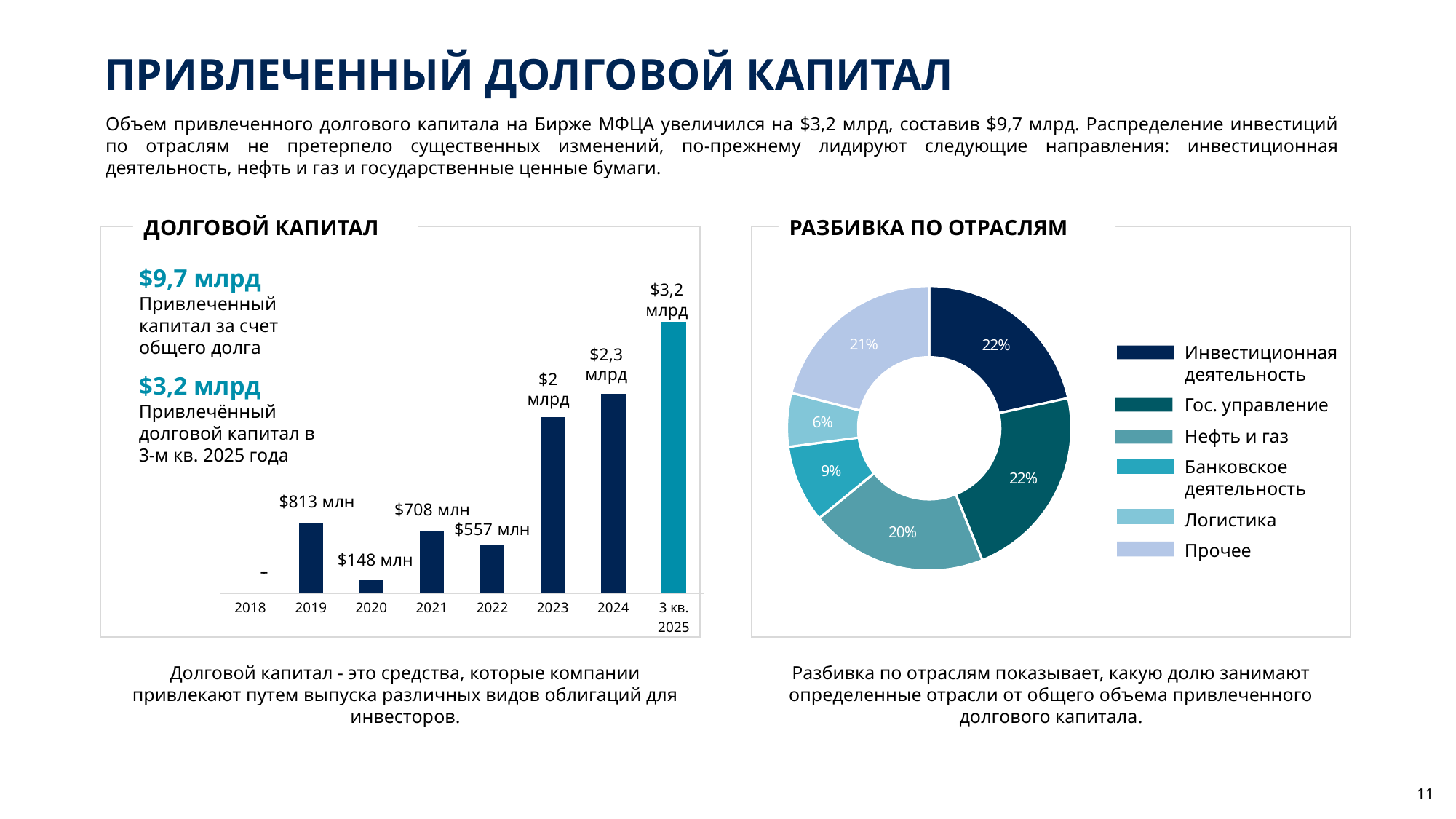
In the РАЗБИВКА ПО ОТРАСЛЯМ chart, which sector has the smallest share? Логистика In the ДОЛГОВОЙ КАПИТАЛ chart, what is the difference between the values for 2019 and 2021? $105 млн How many sectors does the legend of the РАЗБИВКА ПО ОТРАСЛЯМ chart list? 6 In the ДОЛГОВОЙ КАПИТАЛ chart, do the values rise or fall from 2022 to 3 кв. 2025? Rise In the ДОЛГОВОЙ КАПИТАЛ chart, what is the value for 3 кв. 2025? $3,2 млрд How many periods are shown on the x axis of the ДОЛГОВОЙ КАПИТАЛ chart? 8 What kind of chart is the РАЗБИВКА ПО ОТРАСЛЯМ chart? Donut (pie) chart What kind of chart is the ДОЛГОВОЙ КАПИТАЛ chart? Bar chart In the ДОЛГОВОЙ КАПИТАЛ chart, which is larger, the value for 2021 or the value for 2022? 2021 In the ДОЛГОВОЙ КАПИТАЛ chart, which period has the highest value? 3 кв. 2025 In the РАЗБИВКА ПО ОТРАСЛЯМ chart, what share does Нефть и газ have? 20% In the ДОЛГОВОЙ КАПИТАЛ chart, what is the value for 2019? $813 млн